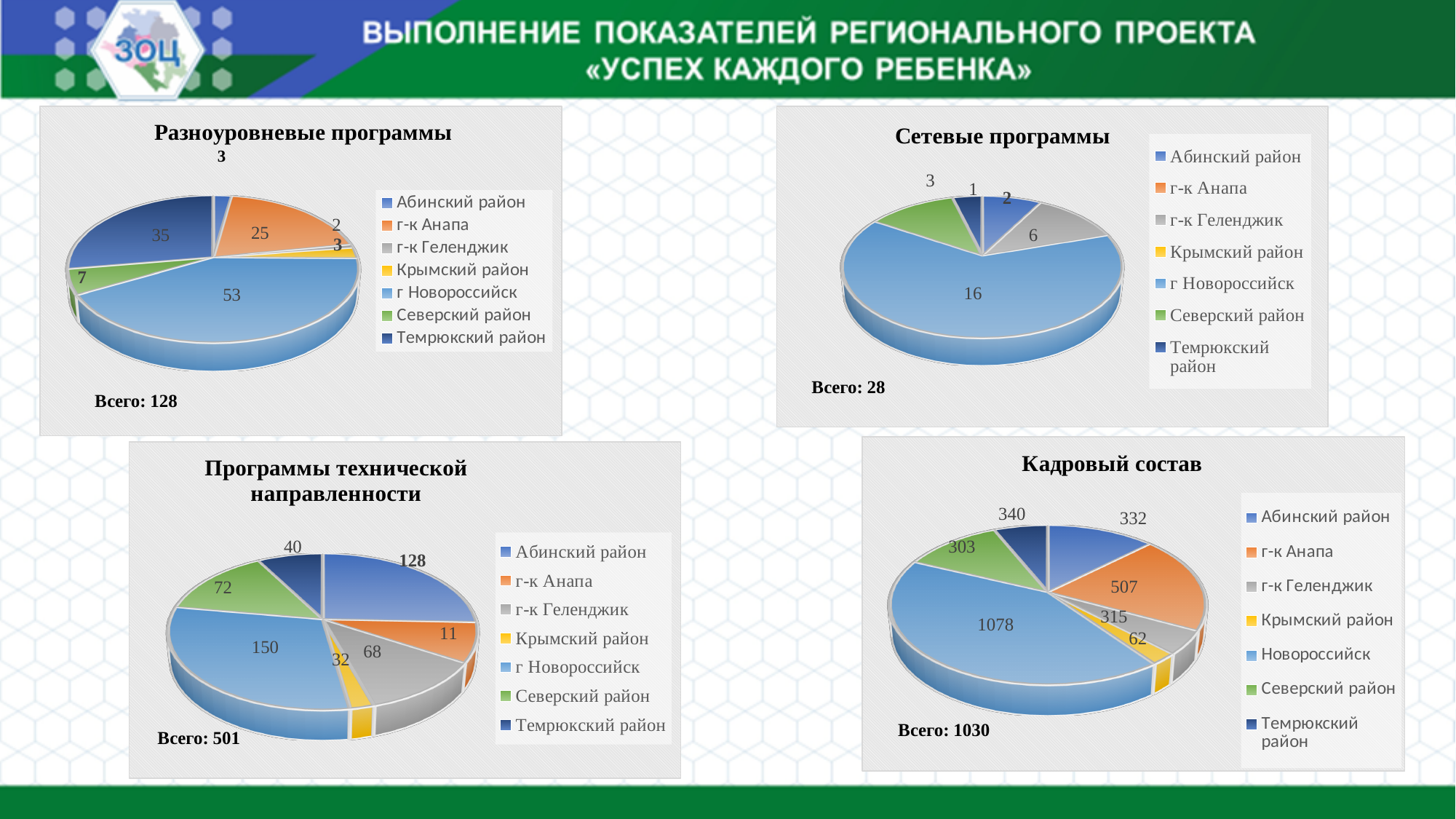
In the 'Сетевые программы' chart, how many series does the legend list? 7 In the 'Кадровый состав' chart, what is the value for г-к Анапа? 507 In the 'Сетевые программы' chart, which category has the lowest non-zero value shown? Темрюкский район In the 'Программы технической направленности' chart, which is larger: the value for Северский район or г-к Геленджик? Северский район In the 'Программы технической направленности' chart, what is the total shown for all categories? 501 In the 'Программы технической направленности' chart, what is the value for Абинский район? 128 In the 'Сетевые программы' chart, what is the value for г-к Геленджик? 6 In the 'Кадровый состав' chart, which category has the lowest value? Крымский район In the 'Разноуровневые программы' chart, what is the value for г Новороссийск? 53 What type of chart is used for 'Кадровый состав'? Pie chart In the 'Разноуровневые программы' chart, what is the difference between the values for Темрюкский район and г-к Анапа? 10 In the 'Разноуровневые программы' chart, which category has the highest value? г Новороссийск